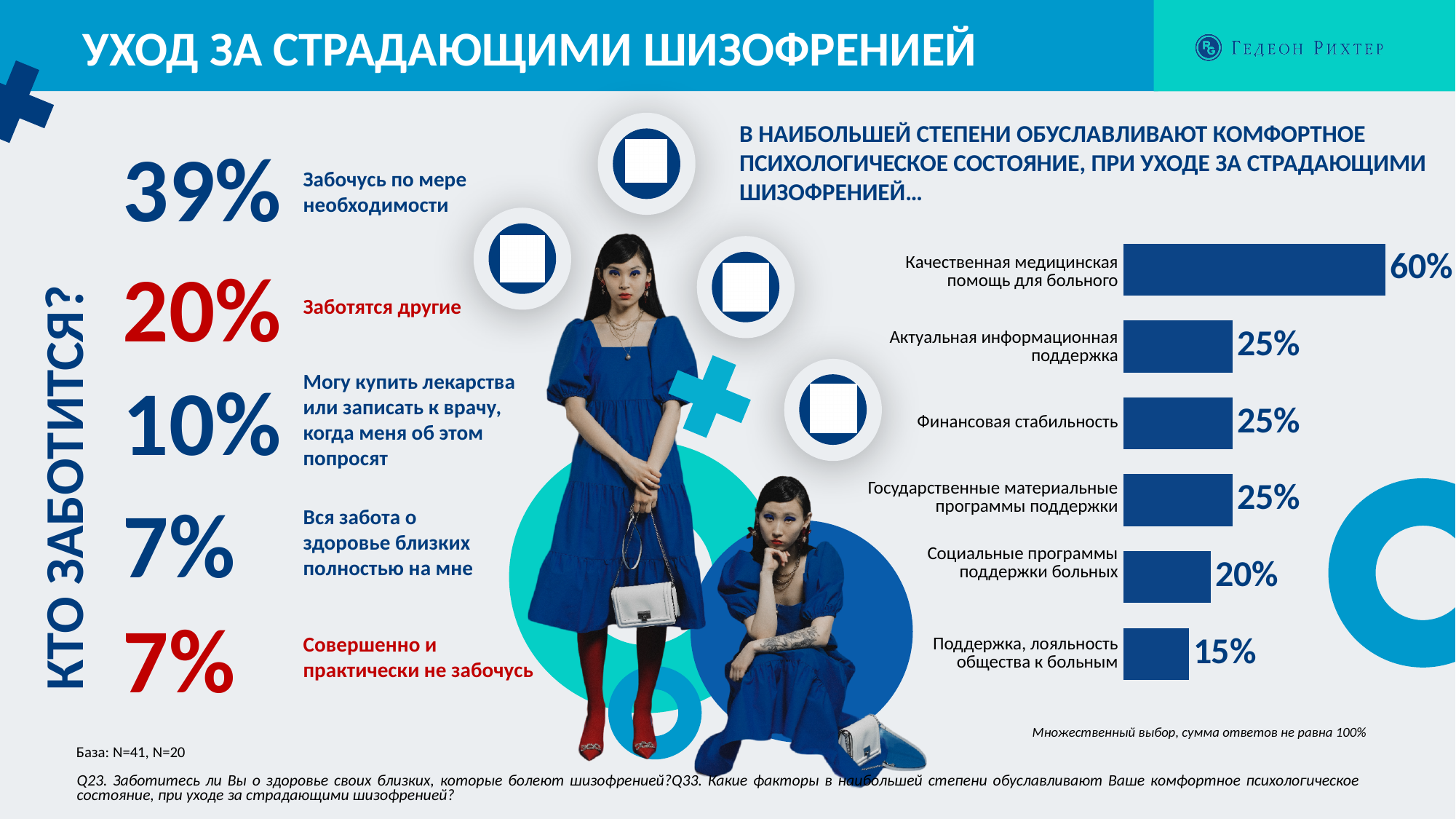
What is the value for "Финансовая стабильность"? 25% How many categories in the bar chart have a value of 25%? 3 What kind of chart is shown on the right side of the slide? bar chart Which is larger: the value for "Государственные материальные программы поддержки" or for "Социальные программы поддержки больных"? Государственные материальные программы поддержки Which category has the highest value in the bar chart? Качественная медицинская помощь для больного What is the difference between the values for "Качественная медицинская помощь для больного" and "Актуальная информационная поддержка"? 35% How many categories are shown in the bar chart? 6 Which category has the lowest value in the bar chart? Поддержка, лояльность общества к больным What is the value for "Качественная медицинская помощь для больного"? 60% What is the value for "Поддержка, лояльность общества к больным"? 15% What is the difference between the values for "Социальные программы поддержки больных" and "Поддержка, лояльность общества к больным"? 5% What is the value for "Социальные программы поддержки больных"? 20%